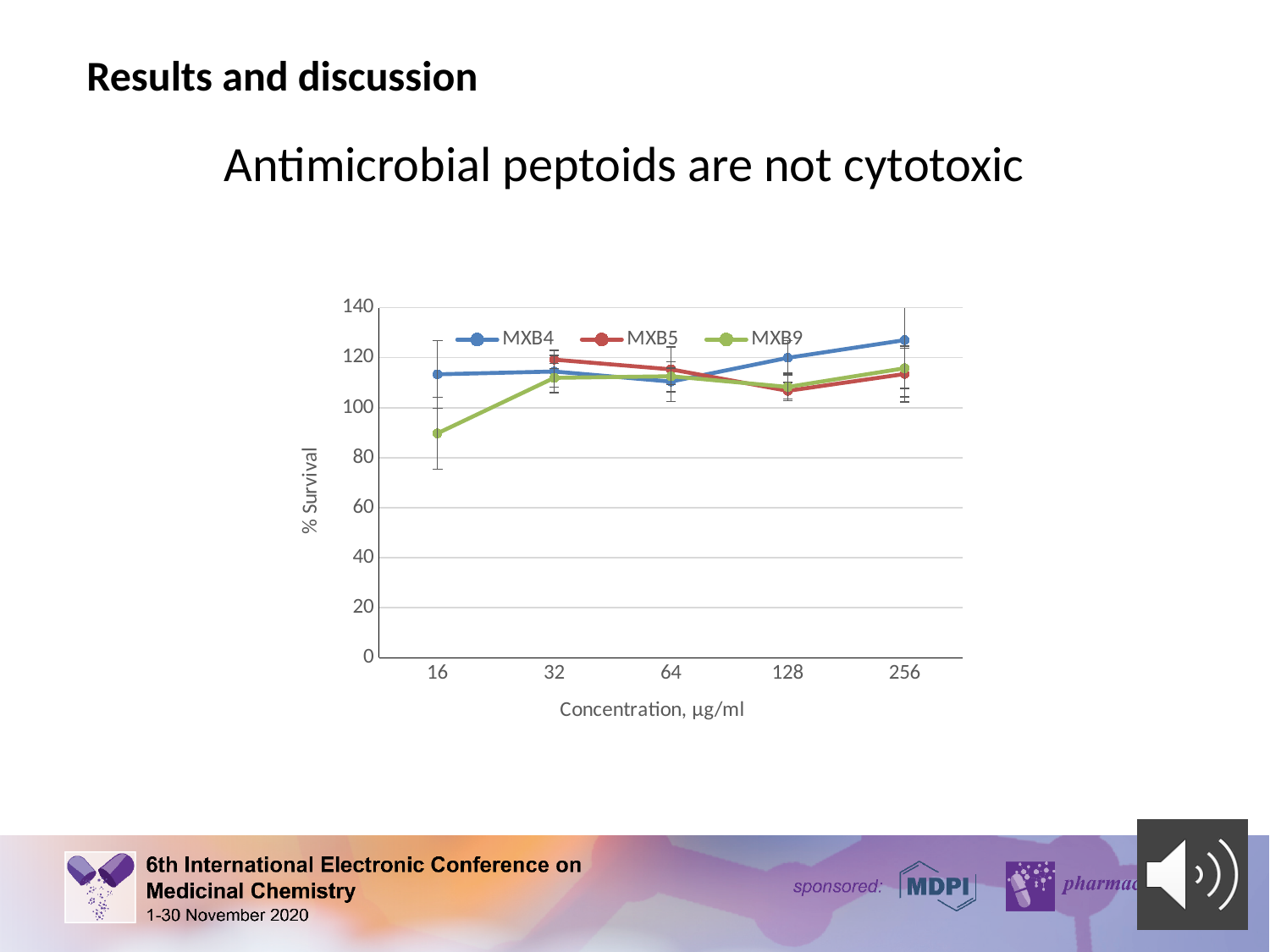
At 16 µg/ml, which series has the larger % Survival value, MXB4 or MXB9? MXB4 Is the % Survival value for MXB4 at 16 µg/ml greater or less than 100? greater At which concentration does the MXB9 series reach its lowest % Survival value? 16 Is the % Survival value for MXB4 at 256 µg/ml greater or less than 120? greater Does the MXB9 series rise or fall between 16 and 32 µg/ml? rise How many concentration values are plotted along the x axis? 5 How many series does the legend list? 3 At 256 µg/ml, which series has the larger % Survival value, MXB4 or MXB5? MXB4 What is the label of the x axis? Concentration, µg/ml Is the % Survival value for MXB9 at 16 µg/ml greater or less than 100? less What kind of chart is shown on the slide? line chart